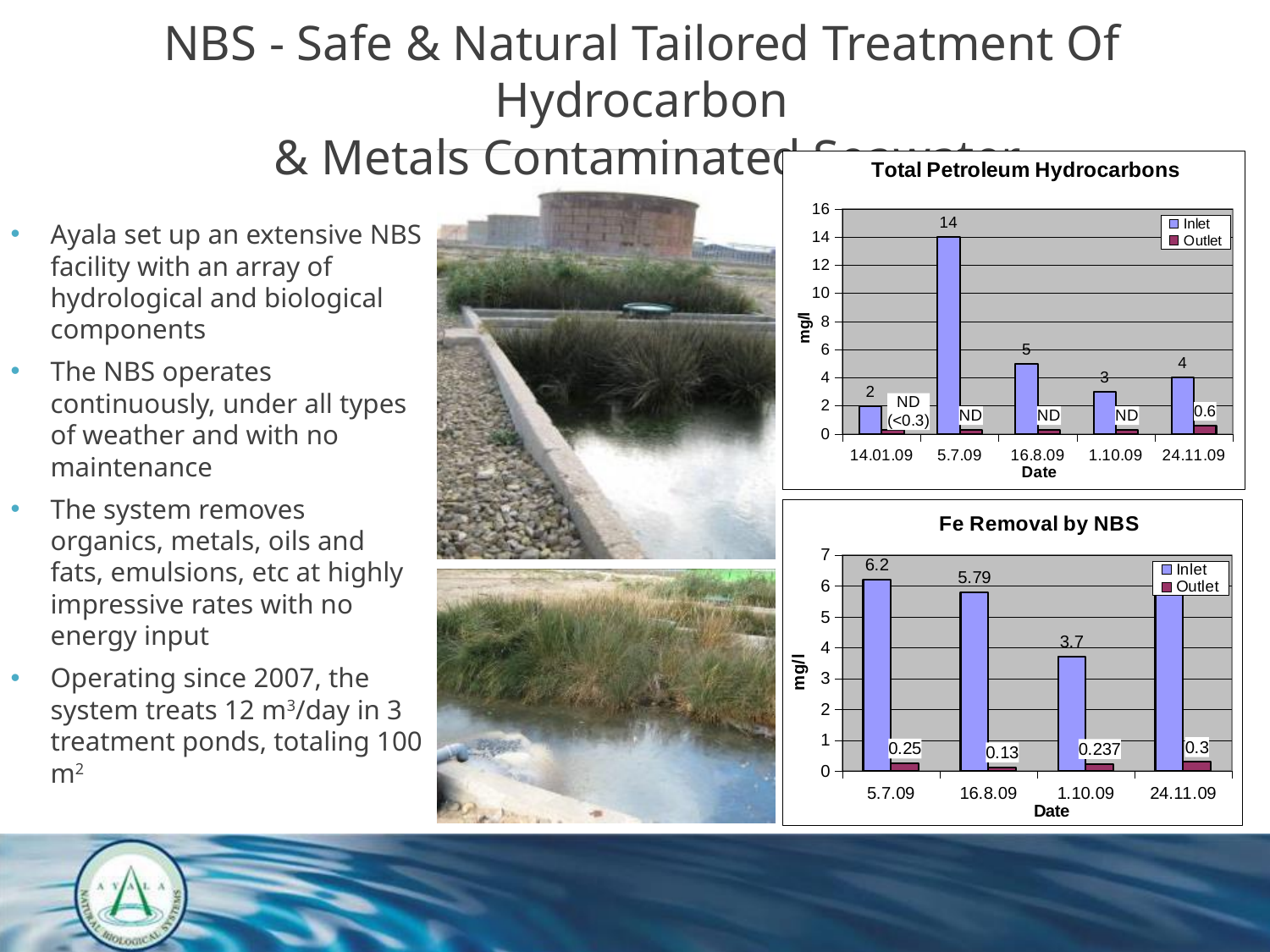
How many series does the legend of the Fe Removal by NBS chart list? 2 In the Total Petroleum Hydrocarbons chart, what is the Outlet label shown for 14.01.09? ND (<0.3) In the Total Petroleum Hydrocarbons chart, which date has the lowest Inlet value? 14.01.09 In the Total Petroleum Hydrocarbons chart, which date has the highest Inlet value? 5.7.09 In the Fe Removal by NBS chart, is the Inlet value on 1.10.09 larger or smaller than the Inlet value on 16.8.09? smaller In the Total Petroleum Hydrocarbons chart, what is the Inlet value on 5.7.09? 14 In the Fe Removal by NBS chart, what is the Outlet value on 1.10.09? 0.237 In the Fe Removal by NBS chart, what is the Inlet value on 5.7.09? 6.2 In the Total Petroleum Hydrocarbons chart, how many dates are shown on the x axis? 5 In the Fe Removal by NBS chart, which date has the lowest Outlet value? 16.8.09 In the Total Petroleum Hydrocarbons chart, what is the difference between the Inlet values on 5.7.09 and 16.8.09? 9 In the Total Petroleum Hydrocarbons chart, what is the Outlet value on 24.11.09? 0.6